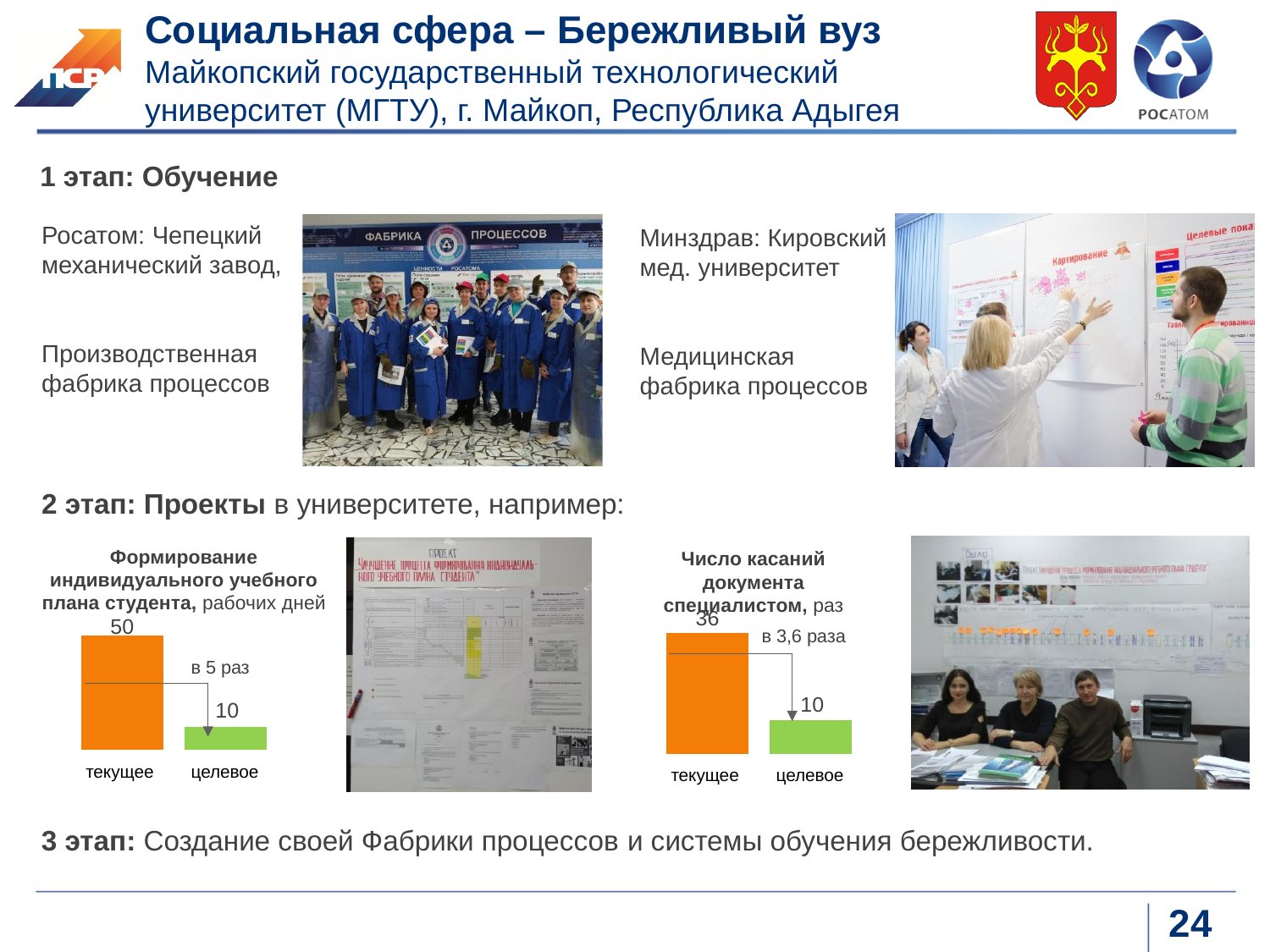
On the right chart (Число касаний документа специалистом), which category has the higher value, текущее or целевое? текущее How many categories are shown on the left chart (Формирование индивидуального учебного плана студента)? 2 On the left chart (Формирование индивидуального учебного плана студента), what reduction factor is annotated between the bars? в 5 раз On the right chart (Число касаний документа специалистом), what reduction factor is annotated between the bars? в 3,6 раза On the left chart (Формирование индивидуального учебного плана студента), what is the value for текущее? 50 On the left chart (Формирование индивидуального учебного плана студента), what is the value for целевое? 10 On the right chart (Число касаний документа специалистом), what is the value for целевое? 10 On the right chart (Число касаний документа специалистом), what is the value for текущее? 36 On the left chart (Формирование индивидуального учебного плана студента), what is the difference between текущее and целевое? 40 What type of chart is the right chart (Число касаний документа специалистом)? bar chart On the right chart (Число касаний документа специалистом), what is the difference between текущее and целевое? 26 On the left chart (Формирование индивидуального учебного плана студента), which category has the lowest value? целевое